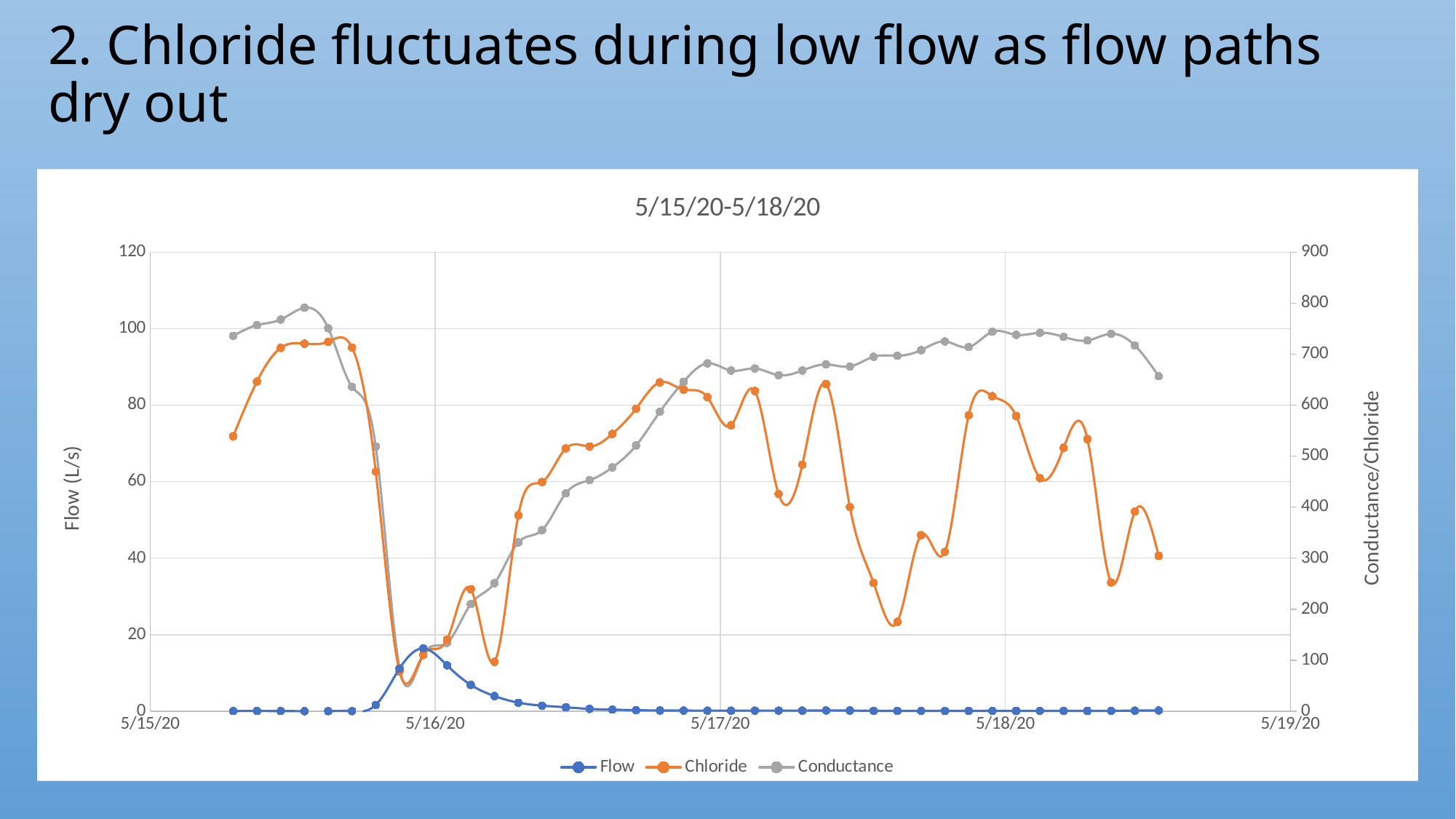
Is the lowest Chloride value after 5/17/20 greater or less than 200? less What kind of chart is shown on the slide? line chart Which series has the higher value at the first plotted point on 5/15/20, Chloride or Conductance? Conductance What is the title of the chart? 5/15/20-5/18/20 How many series does the legend list? 3 Is the peak value of the Flow series greater or less than 20 L/s? less What are the names of the three series in the legend? Flow, Chloride, Conductance Does the Flow series rise or fall between its peak near 5/16/20 and 5/17/20? fall Which series is plotted against the left axis labelled Flow (L/s)? Flow Is the highest Conductance value greater or less than 700? greater Does the Conductance series generally rise or fall between 5/16/20 and 5/17/20? rise